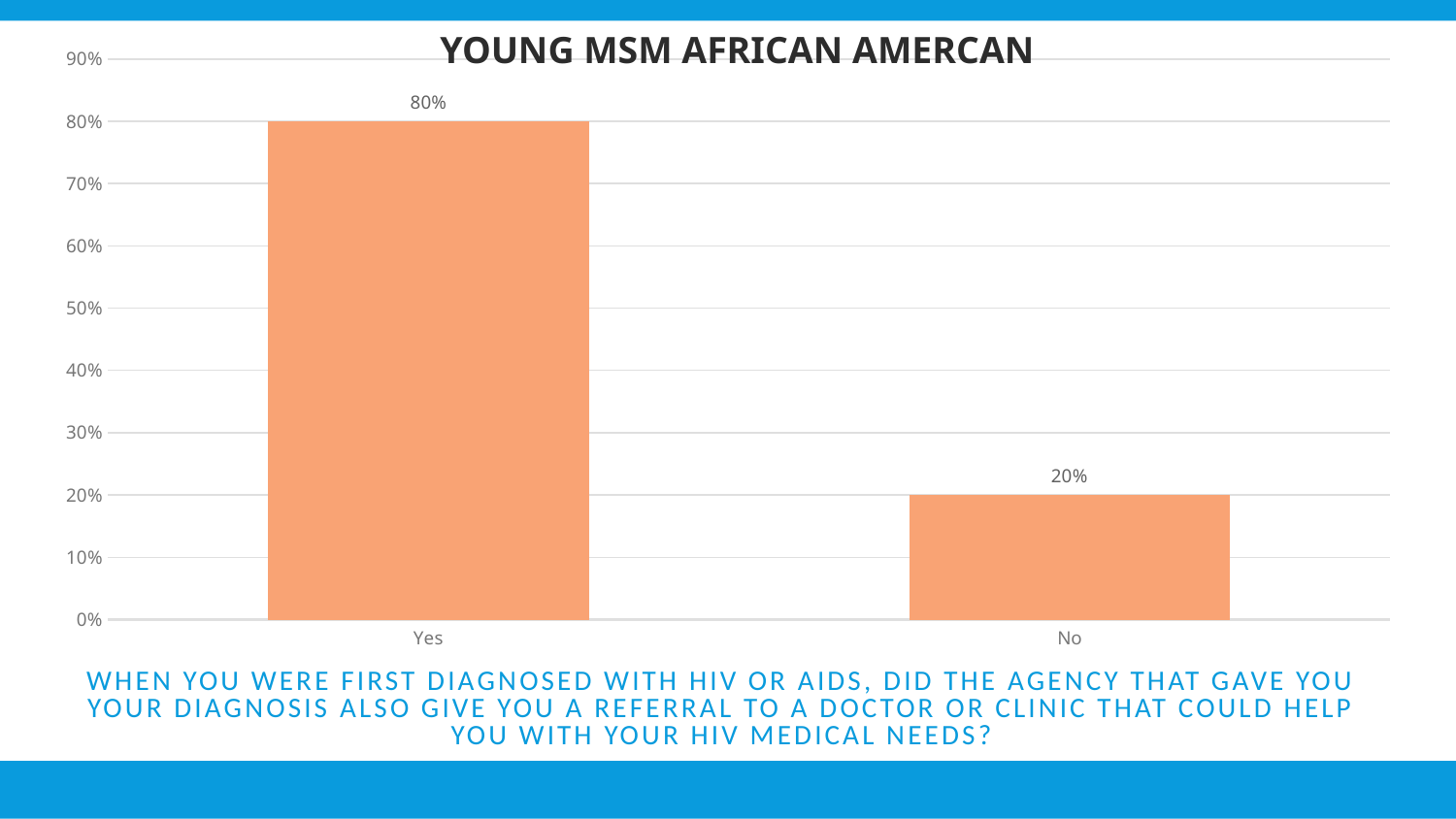
Which is larger, the value for Yes or the value for No? Yes What kind of chart is shown on the slide? bar chart Which category has the highest value? Yes How many categories are shown on the x axis? 2 What is the value for Yes? 80% What is the difference between the values for Yes and No? 60% What is the value for No? 20% Is the value for Yes greater or less than 50%? greater Is the value for No greater or less than 30%? less What is the title of the chart? YOUNG MSM AFRICAN AMERCAN Which category has the lowest value? No What is the highest value shown on the y axis? 90%